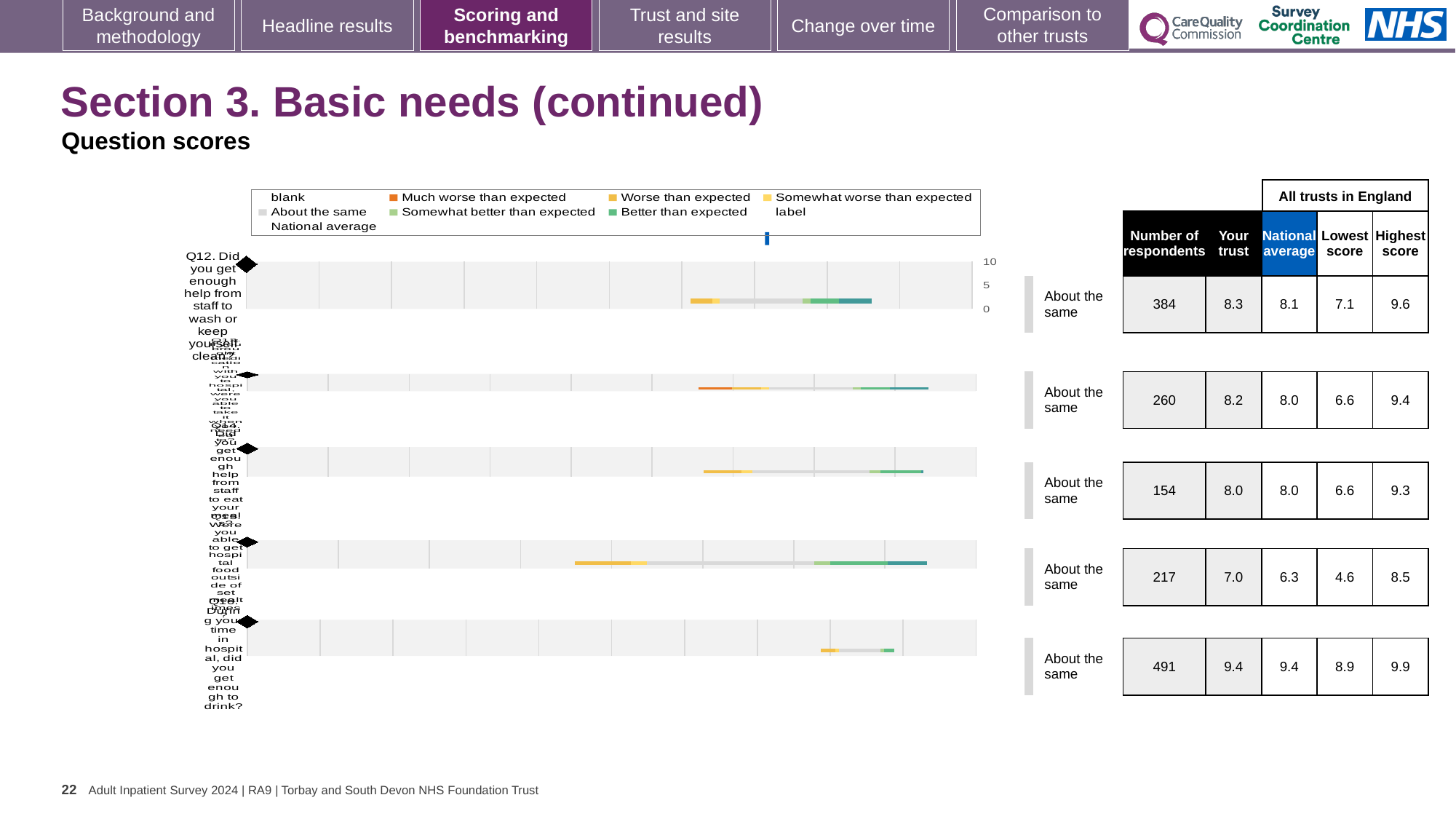
Which question row has the highest 'Your trust' score? Q16 (did you get enough to drink), 9.4 What is the national average score for Q12 (help from staff to wash or keep yourself clean)? 8.1 Which question row has the lowest 'Your trust' score? the fourth row, 7.0 How many question rows are plotted in the chart? 5 What benchmark category is shown for every question row in the chart? About the same What is the number of respondents for Q16 (did you get enough to drink)? 491 For the fourth question row, which is larger: the 'Your trust' score or the national average? Your trust (7.0) What kind of chart is used to show the question scores on this slide? bar chart What is the highest score among all trusts in England for Q14 (help from staff to eat your meals)? 9.3 Which question row has the fewest respondents? Q14 (help from staff to eat your meals), 154 What is the difference between the 'Your trust' score and the national average for Q12? 0.2 What is the 'Your trust' score for Q12 (help from staff to wash or keep yourself clean)? 8.3